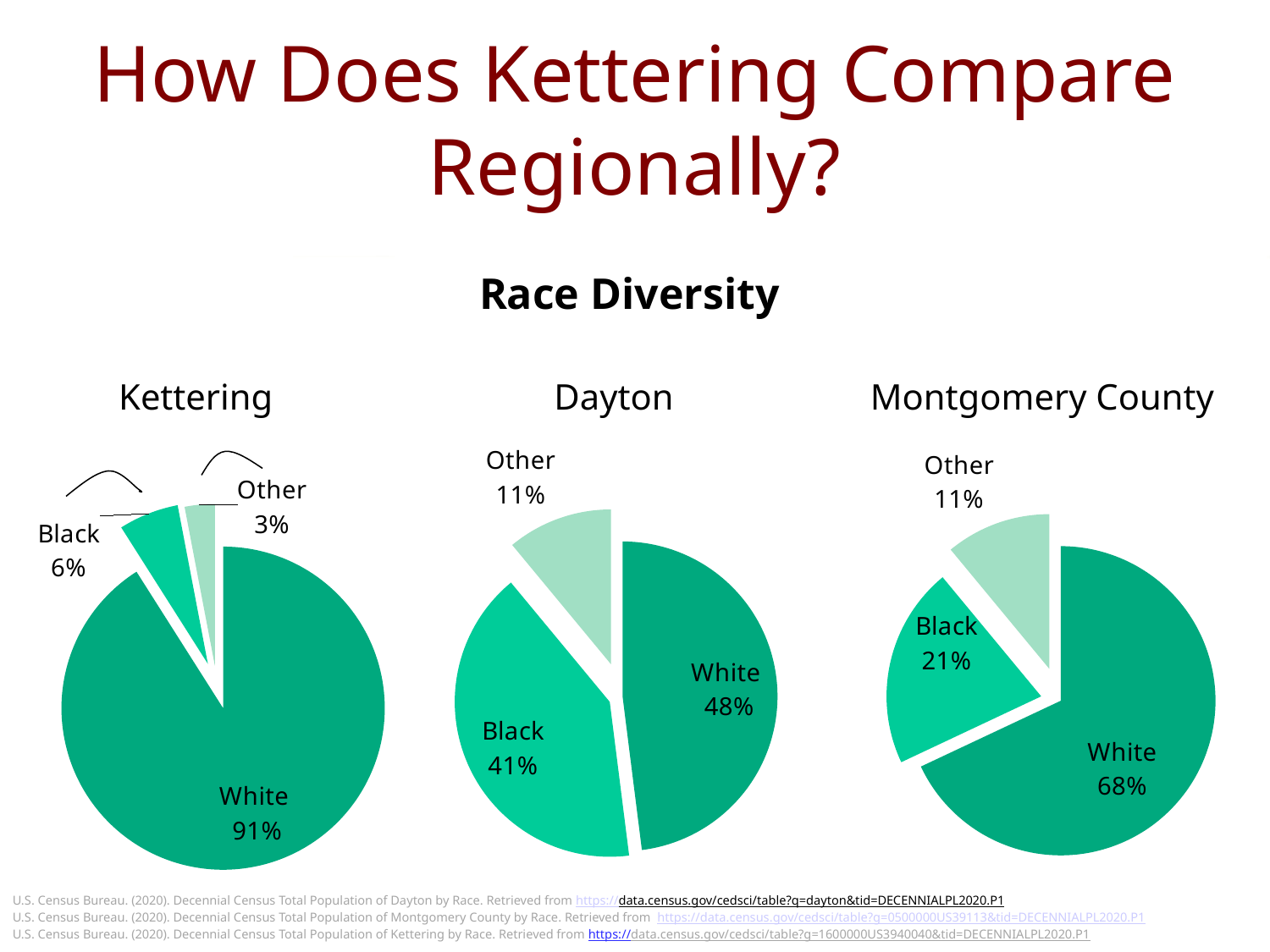
In the Dayton pie chart, which is larger, the White slice or the Black slice? White What type of chart is used to show race diversity for Kettering, Dayton and Montgomery County? Pie chart What is the difference between the White percentage in Kettering and the White percentage in Dayton? 43% How many pie charts are shown on the slide? 3 In the Kettering pie chart, what percentage is labelled for White? 91% How many slices does the Dayton pie chart have? 3 In the Kettering pie chart, which category has the smallest slice? Other What is the title shown above the three pie charts? Race Diversity In the Montgomery County pie chart, what percentage is labelled for Other? 11% In the Montgomery County pie chart, which category has the largest slice? White In the Montgomery County pie chart, what is the difference between the White and Black percentages? 47% In the Dayton pie chart, what percentage is labelled for Black? 41%